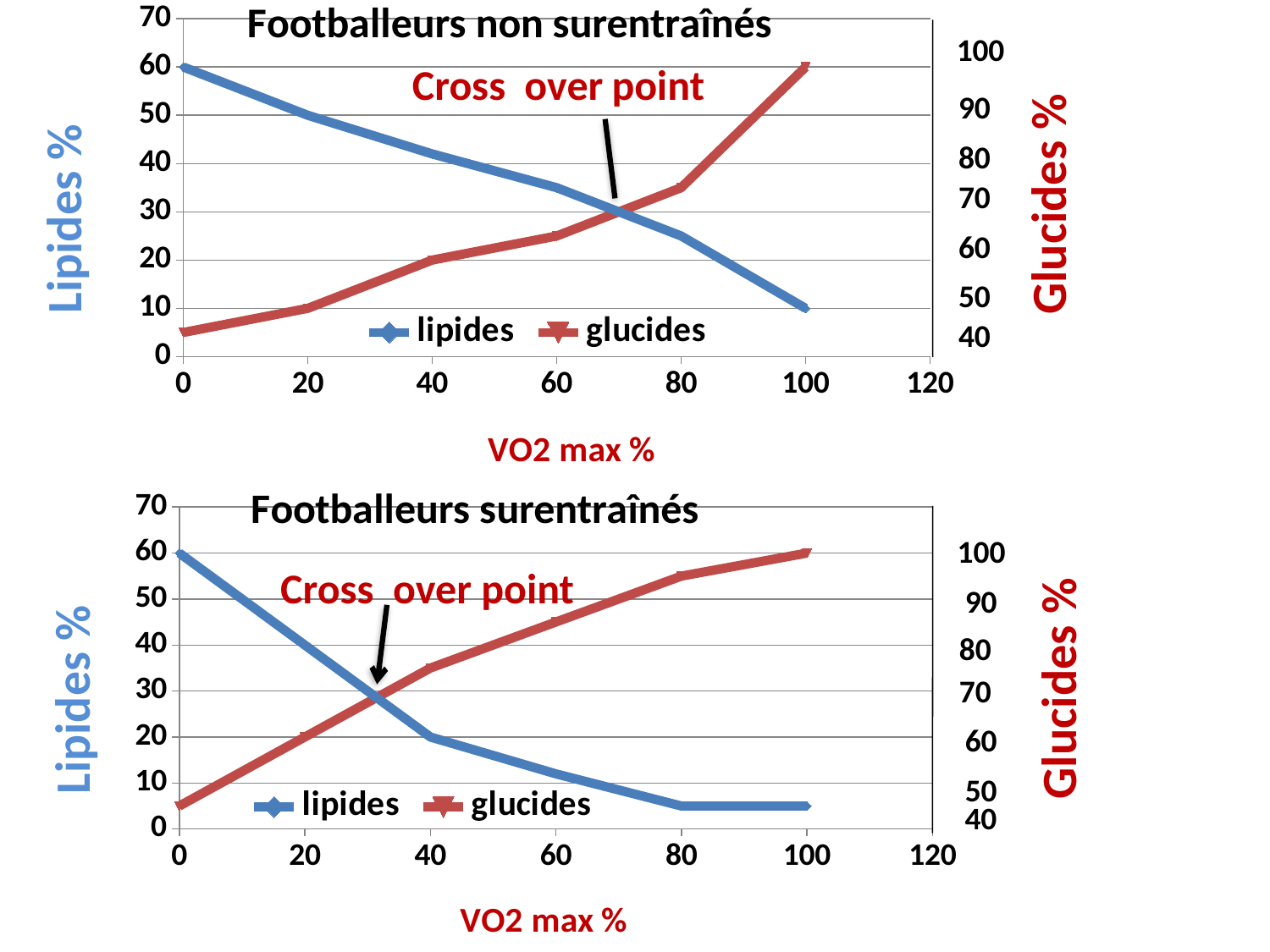
In the 'Footballeurs non surentraînés' chart, does the lipides series rise or fall as VO2 max % increases? fall What kind of chart is the 'Footballeurs non surentraînés' chart? line chart In the 'Footballeurs non surentraînés' chart, what is the lipides value at VO2 max 100%? 10 In the 'Footballeurs surentraînés' chart, what is the glucides value at VO2 max 100%? 100 In the 'Footballeurs surentraînés' chart, what is the lipides value at VO2 max 40%? 20 In the 'Footballeurs non surentraînés' chart, is the lipides value at VO2 max 60% greater or less than 30? greater How many series does the legend of the 'Footballeurs surentraînés' chart list? 2 In the 'Footballeurs surentraînés' chart, is the lipides value at VO2 max 80% greater or less than 10? less What is the x-axis label of the 'Footballeurs surentraînés' chart? VO2 max % In the 'Footballeurs surentraînés' chart, does the glucides series rise or fall as VO2 max % increases? rise In the 'Footballeurs non surentraînés' chart, at which VO2 max % is the lipides value highest? 0 In the 'Footballeurs non surentraînés' chart, what is the lipides value at VO2 max 0%? 60